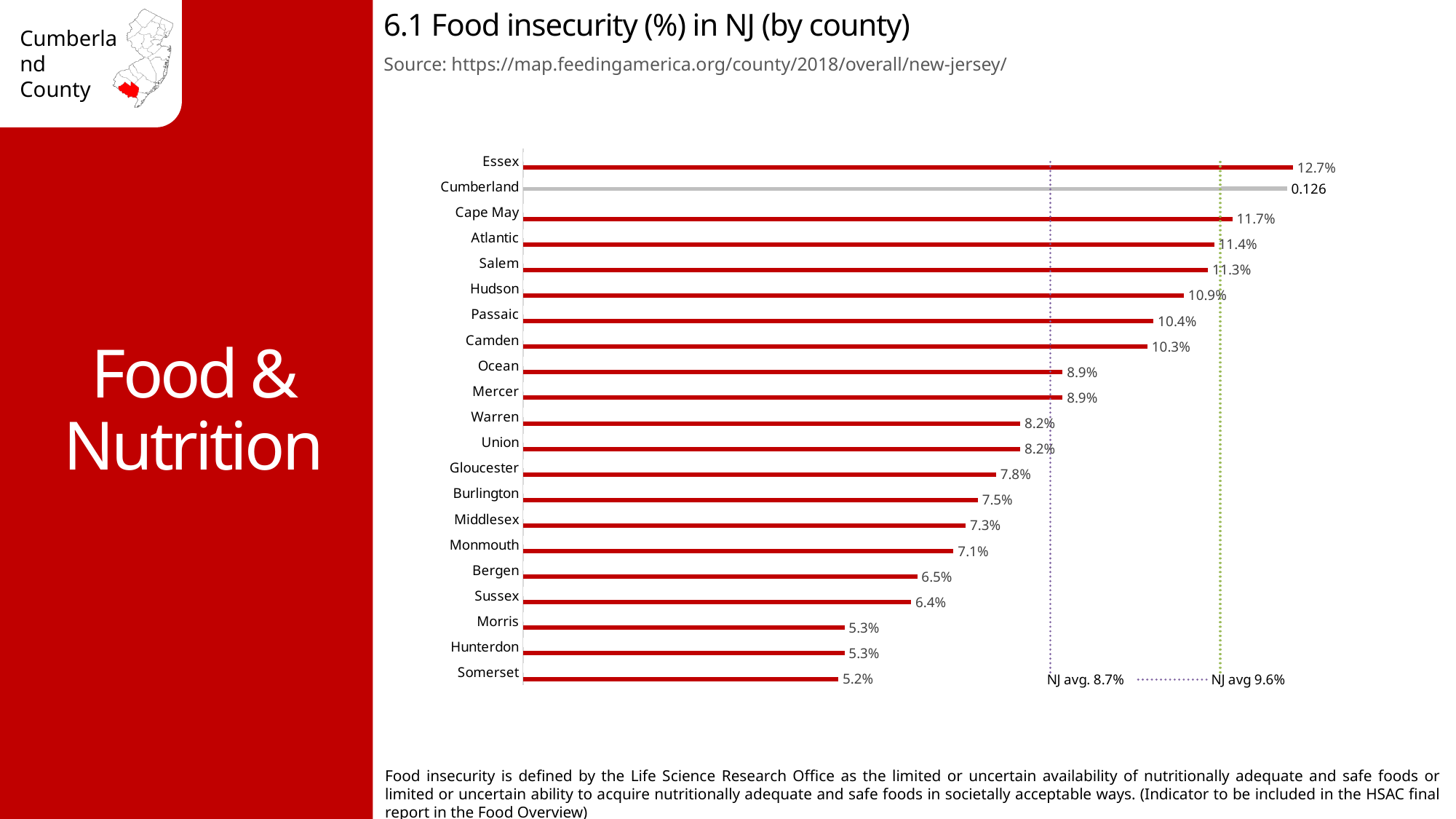
What value label is printed next to the Cumberland bar? 0.126 What is the food insecurity value shown for Camden county? 10.3% Which county has a higher food insecurity percentage, Hudson or Passaic? Hudson What is the food insecurity value shown for Essex county? 12.7% Which county has the highest food insecurity percentage in the chart? Essex What two NJ average values are marked by the dotted vertical lines? 8.7% and 9.6% What is the difference in food insecurity between Essex (12.7%) and Somerset (5.2%)? 7.5 percentage points What is the food insecurity value shown for Bergen county? 6.5% What is the difference in food insecurity between Cape May (11.7%) and Salem (11.3%)? 0.4 percentage points What kind of chart is used to show food insecurity by county? Bar chart Which county has the lowest food insecurity percentage in the chart? Somerset How many counties are listed in the chart? 21